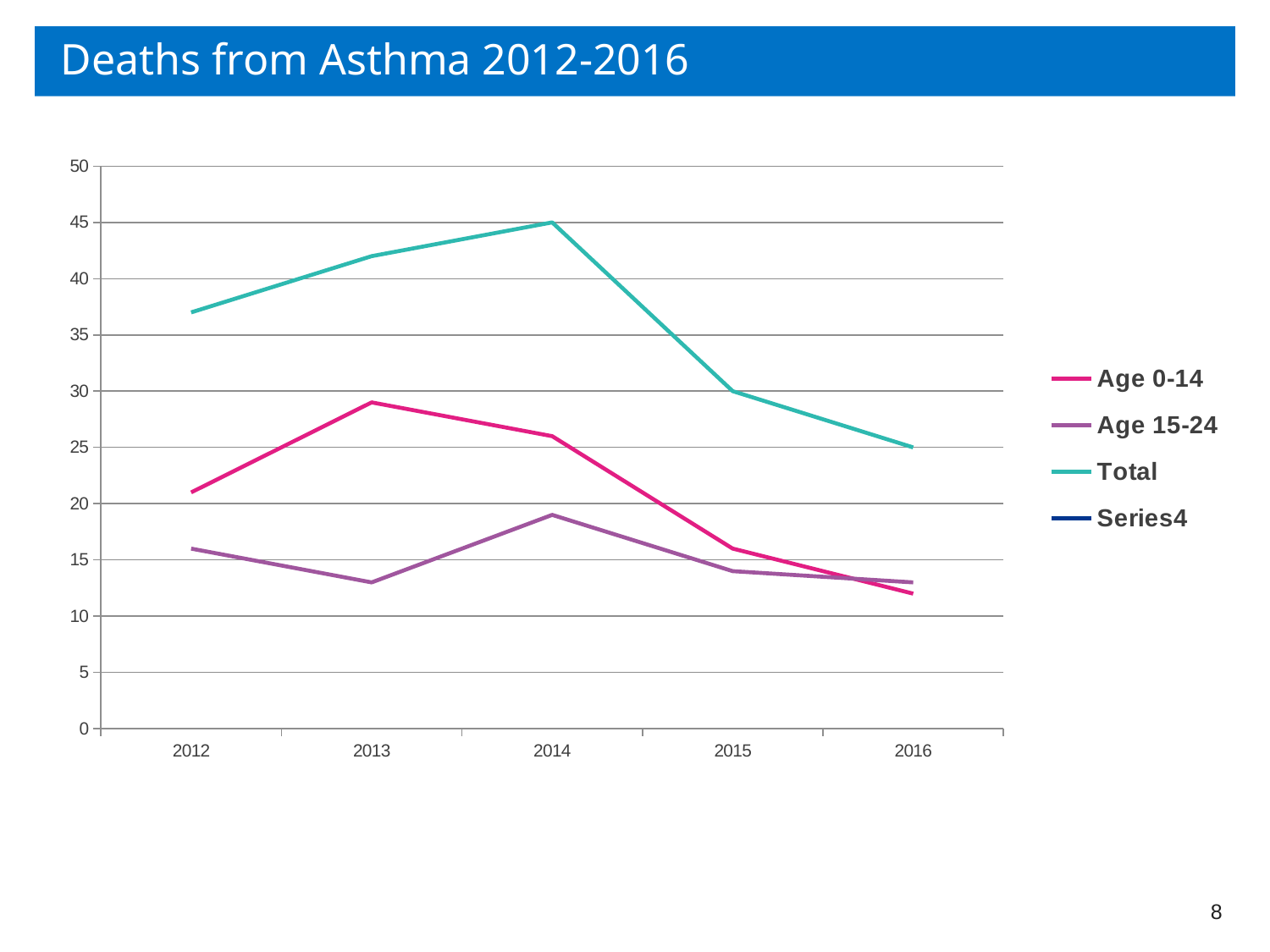
In which year does the Total series reach its highest value? 2014 What is the value of the Total series in 2016? 25 How many series does the legend list? 4 Which series has the larger value in 2013, Age 0-14 or Age 15-24? Age 0-14 In which year does the Age 0-14 series reach its highest value? 2013 Is the value for Age 0-14 in 2013 greater or less than 25? greater What is the value of the Total series in 2014? 45 By how much did the Total series fall from 2014 to 2015? 15 How many years are shown on the x axis? 5 What is the value of the Total series in 2015? 30 What type of chart is shown on the slide? line chart Does the Total series rise or fall from 2014 to 2016? fall